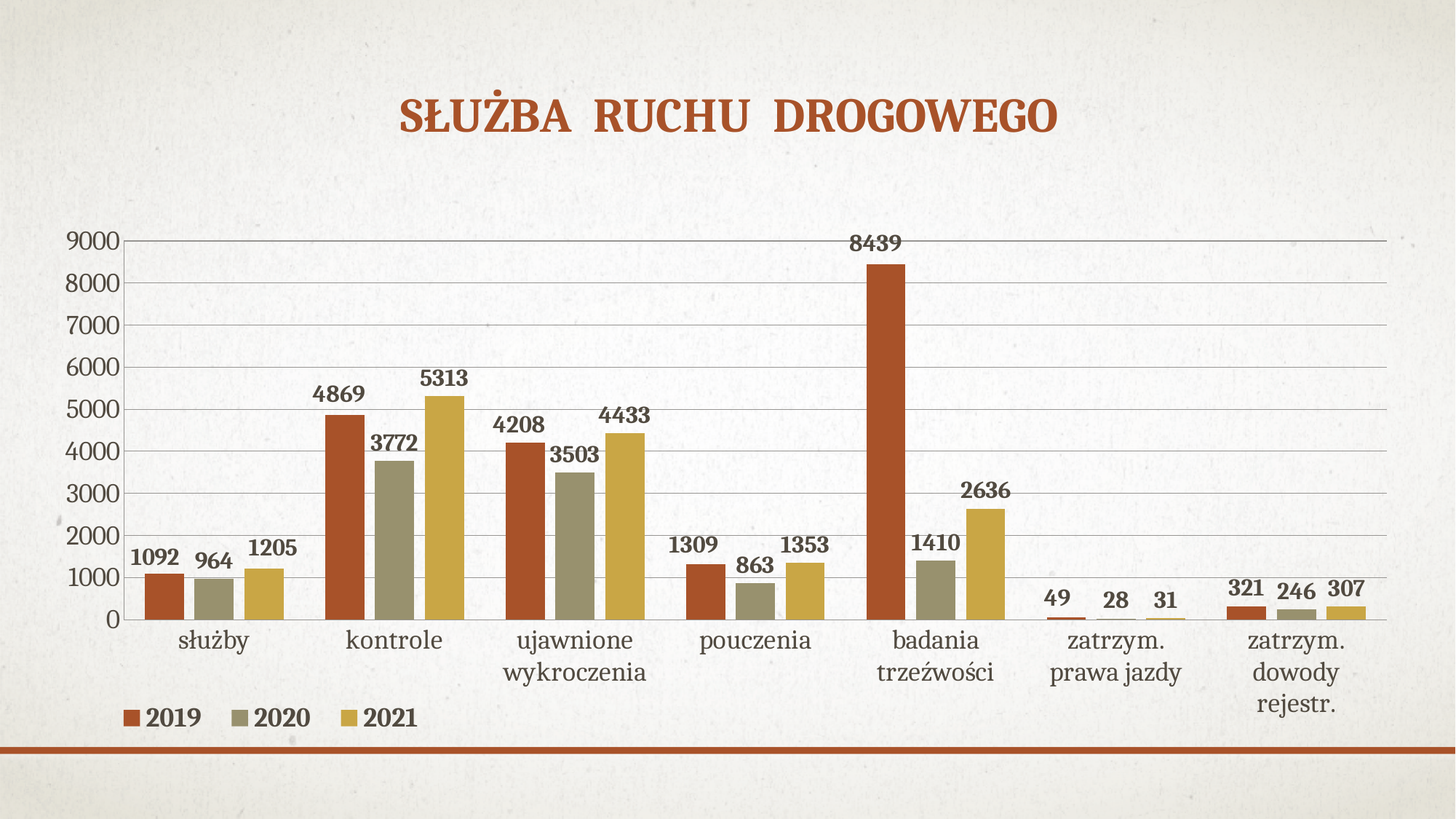
What is the value for 'pouczenia' in 2020? 863 How many series does the legend list? 3 Which category has the highest value in the 2019 series? badania trzeźwości What kind of chart is shown on the slide? bar chart What is the value for 'kontrole' in 2021? 5313 Which category has the lowest value in the 2021 series? zatrzym. prawa jazdy What is the value for 'badania trzeźwości' in 2019? 8439 Which is larger for 'służby': the 2019 value or the 2021 value? 2021 What is the title of the chart? SŁUŻBA RUCHU DROGOWEGO Is the 2021 value for 'badania trzeźwości' greater or less than 3000? less What is the difference between the 2021 and 2020 values for 'ujawnione wykroczenia'? 930 How many categories are shown on the x axis? 7